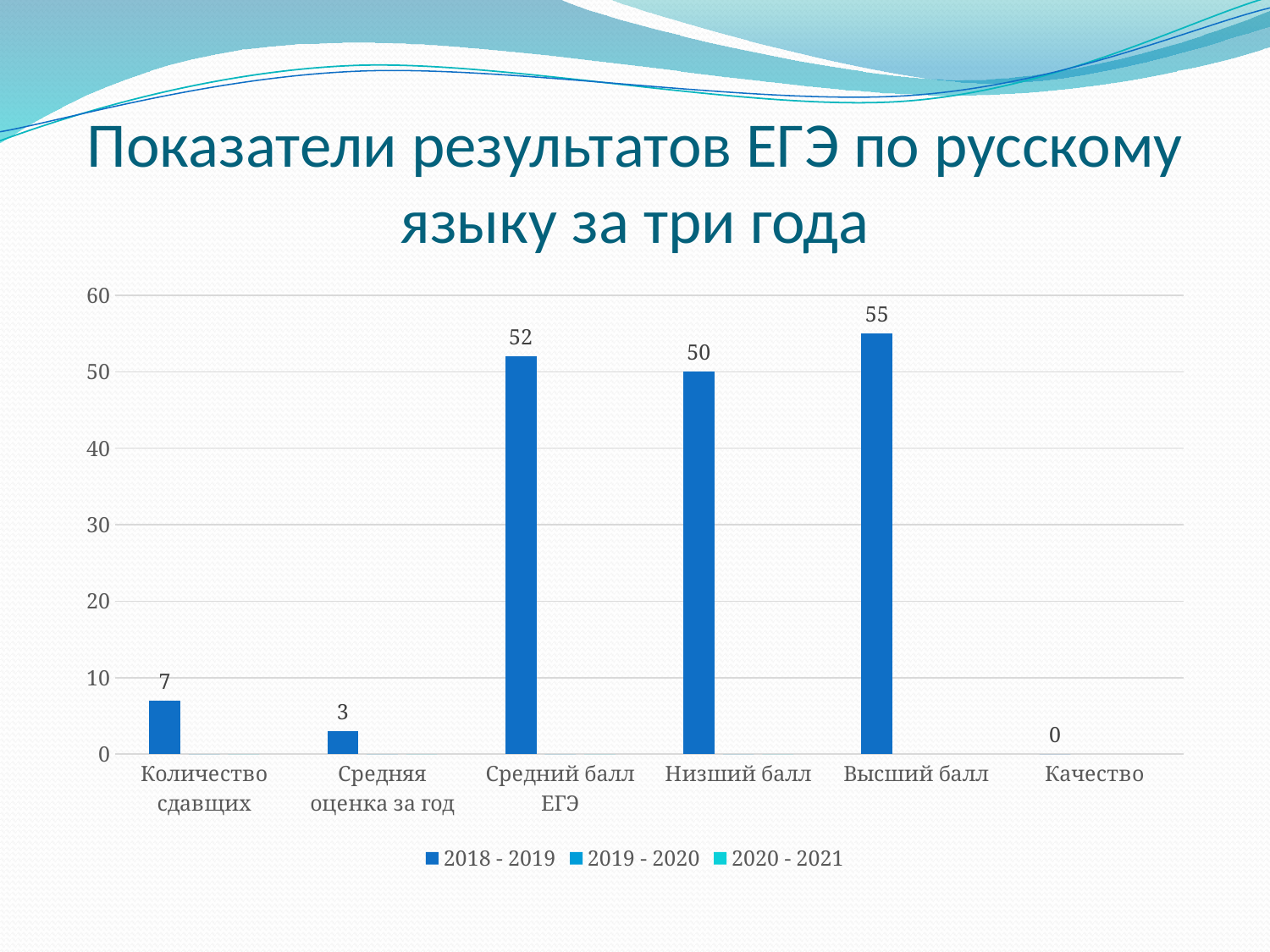
What is the title of the chart on the slide? Показатели результатов ЕГЭ по русскому языку за три года What is the difference between the values for Высший балл and Низший балл? 5 Which category has the lowest value? Качество What is the value for Качество? 0 Which category has the highest value? Высший балл What is the value for Количество сдавщих? 7 What is the value for Высший балл? 55 How many series does the legend list? 3 What kind of chart is shown on the slide? bar chart Which is larger, the value for Средний балл ЕГЭ or the value for Низший балл? Средний балл ЕГЭ How many categories are shown on the x axis? 6 What is the value for Средний балл ЕГЭ? 52